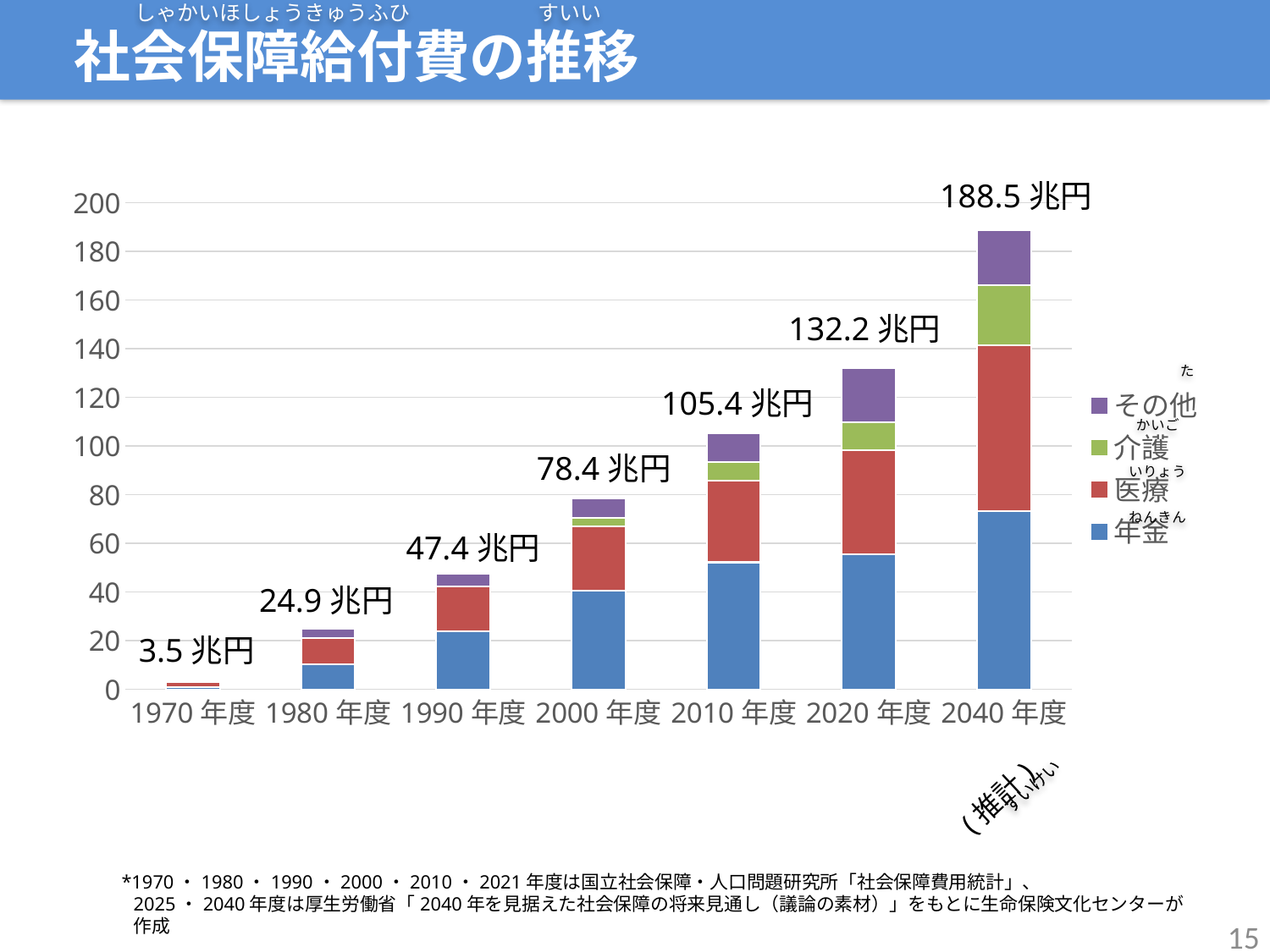
How many series does the legend list? 4 Which fiscal year has the highest total? 2040年度 Is the value of the 年金 segment for 2040年度 greater or less than 60? greater What is the total value labelled for 2010年度? 105.4兆円 Which fiscal year has the lowest total? 1970年度 What kind of chart is shown on the slide? Stacked bar chart How many fiscal years are shown on the x axis? 7 What is the difference between the totals for 2040年度 and 2020年度? 56.3兆円 What is the total social security benefit expenditure shown for 2040年度? 188.5兆円 Which is larger, the total for 2010年度 or the total for 2020年度? 2020年度 What is the total value labelled for 1990年度? 47.4兆円 What is the difference between the totals for 2000年度 and 1980年度? 53.5兆円